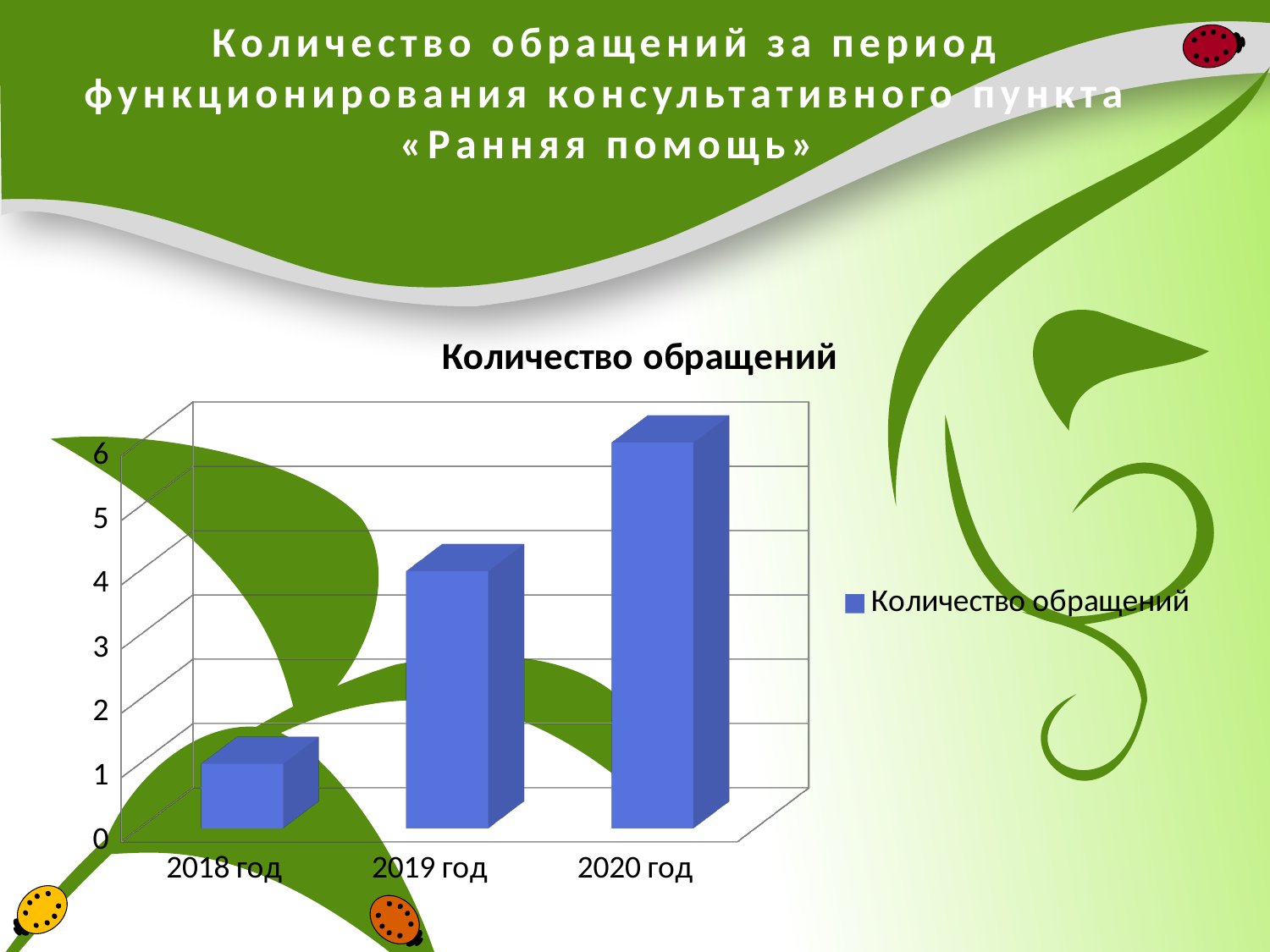
Is the value for 2020 год greater or less than 5? greater Which year has the lowest number of обращений in the chart? 2018 год What kind of chart is shown on the slide? Bar chart Which is larger: the value for 2019 год or the value for 2018 год? 2019 год Which year has the highest number of обращений in the chart? 2020 год What is the title of the chart? Количество обращений How many series does the chart legend list? 1 Do the values rise or fall from 2018 год to 2020 год? rise Is the value for 2018 год greater or less than 2? less How many categories (years) are shown on the x axis of the chart? 3 Is the value for 2019 год greater or less than 3? greater Which is larger: the value for 2020 год or the value for 2019 год? 2020 год